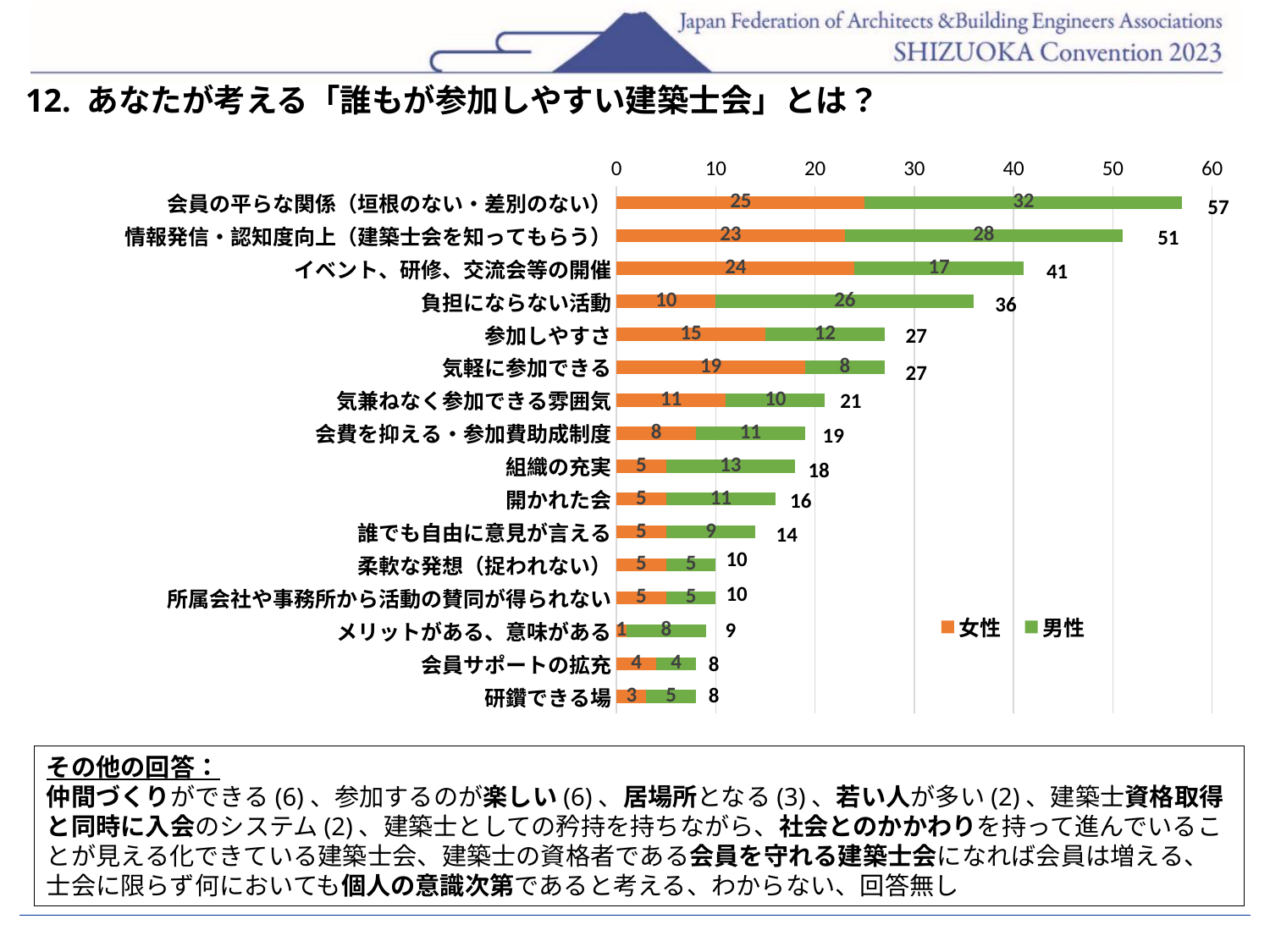
What is the 男性 value for 負担にならない活動? 26 What is the 女性 value for メリットがある、意味がある? 1 How many series does the legend list? 2 How many categories are plotted in the chart? 16 What is the 女性 value for 会員の平らな関係（垣根のない・差別のない）? 25 Which category has the highest total? 会員の平らな関係（垣根のない・差別のない） Which is larger for 気軽に参加できる, the 女性 value or the 男性 value? 女性 What is the difference between the 男性 and 女性 values for イベント、研修、交流会等の開催? 7 Which colour represents the 男性 series in the chart? Green What is the total for 情報発信・認知度向上（建築士会を知ってもらう）? 51 What is the total for 研鑽できる場? 8 What kind of chart is shown on the slide? Stacked bar chart